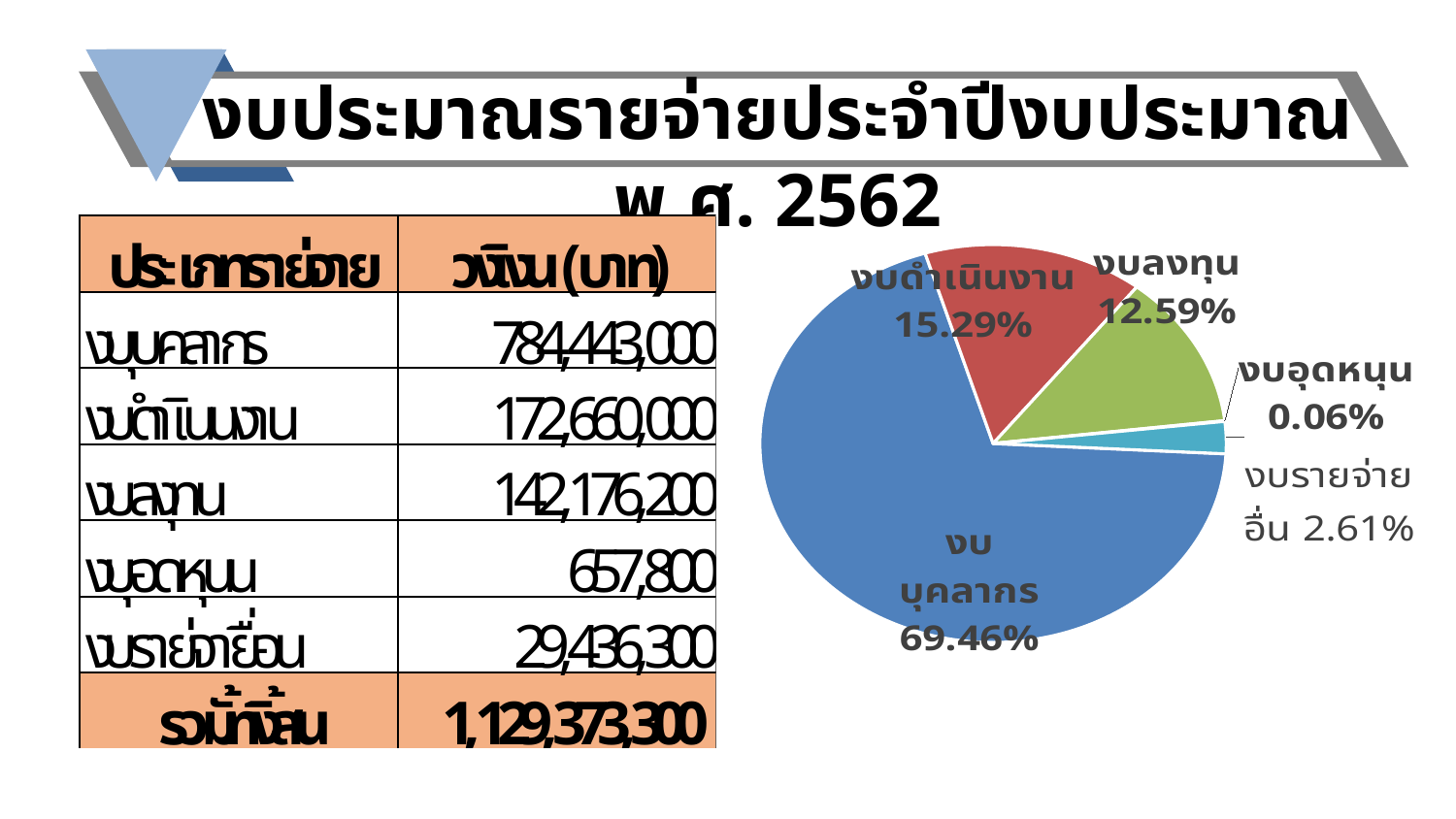
What share of the pie does งบอุดหนุน represent? 0.06% What colour is the งบบุคลากร slice in the pie chart? blue Which slice of the pie chart is the smallest? งบอุดหนุน What share of the pie does งบรายจ่ายอื่น represent? 2.61% Which is larger in the pie chart, งบดำเนินงาน or งบลงทุน? งบดำเนินงาน How many slices does the pie chart have? 5 What is the difference in percentage points between the งบดำเนินงาน and งบลงทุน slices? 2.70% What share of the pie does งบบุคลากร represent? 69.46% What kind of chart is shown on the slide? pie chart Which slice of the pie chart is the largest? งบบุคลากร